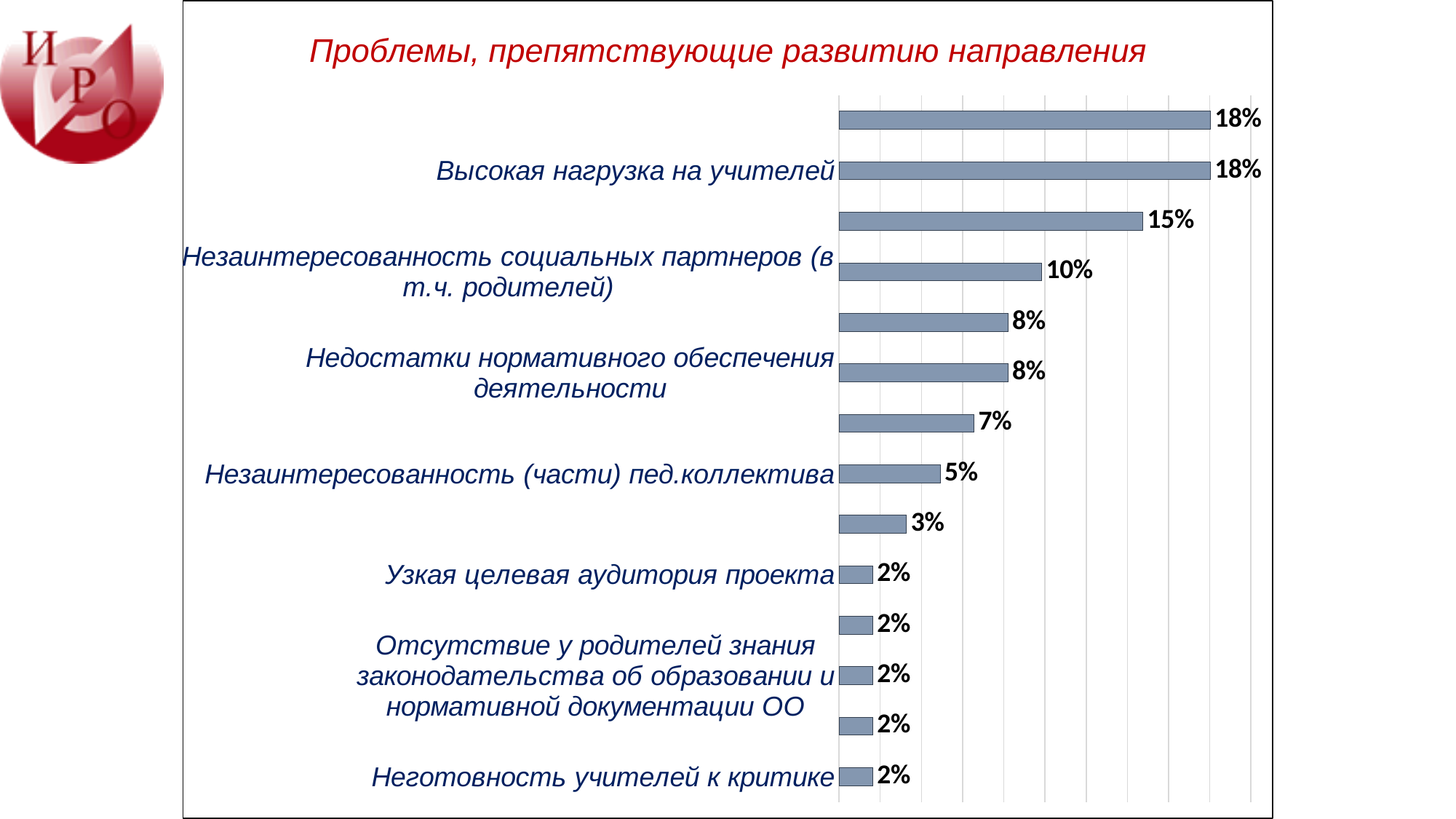
What is the value for "Незаинтересованность социальных партнеров (в т.ч. родителей)"? 10% What is the title of the chart? Проблемы, препятствующие развитию направления What is the value for "Высокая нагрузка на учителей"? 18% How many bars are plotted in the chart? 14 What is the value for "Недостатки нормативного обеспечения деятельности"? 8% What is the value for "Неготовность учителей к критике"? 2% Which is larger, the value for "Недостатки нормативного обеспечения деятельности" or the value for "Незаинтересованность (части) пед.коллектива"? Недостатки нормативного обеспечения деятельности What is the difference between the values for "Высокая нагрузка на учителей" and "Незаинтересованность социальных партнеров (в т.ч. родителей)"? 8% What kind of chart is shown on the slide? bar chart What is the highest value shown in the chart? 18% Do the bar values increase or decrease going from the top of the chart to the bottom? decrease What is the value for "Незаинтересованность (части) пед.коллектива"? 5%